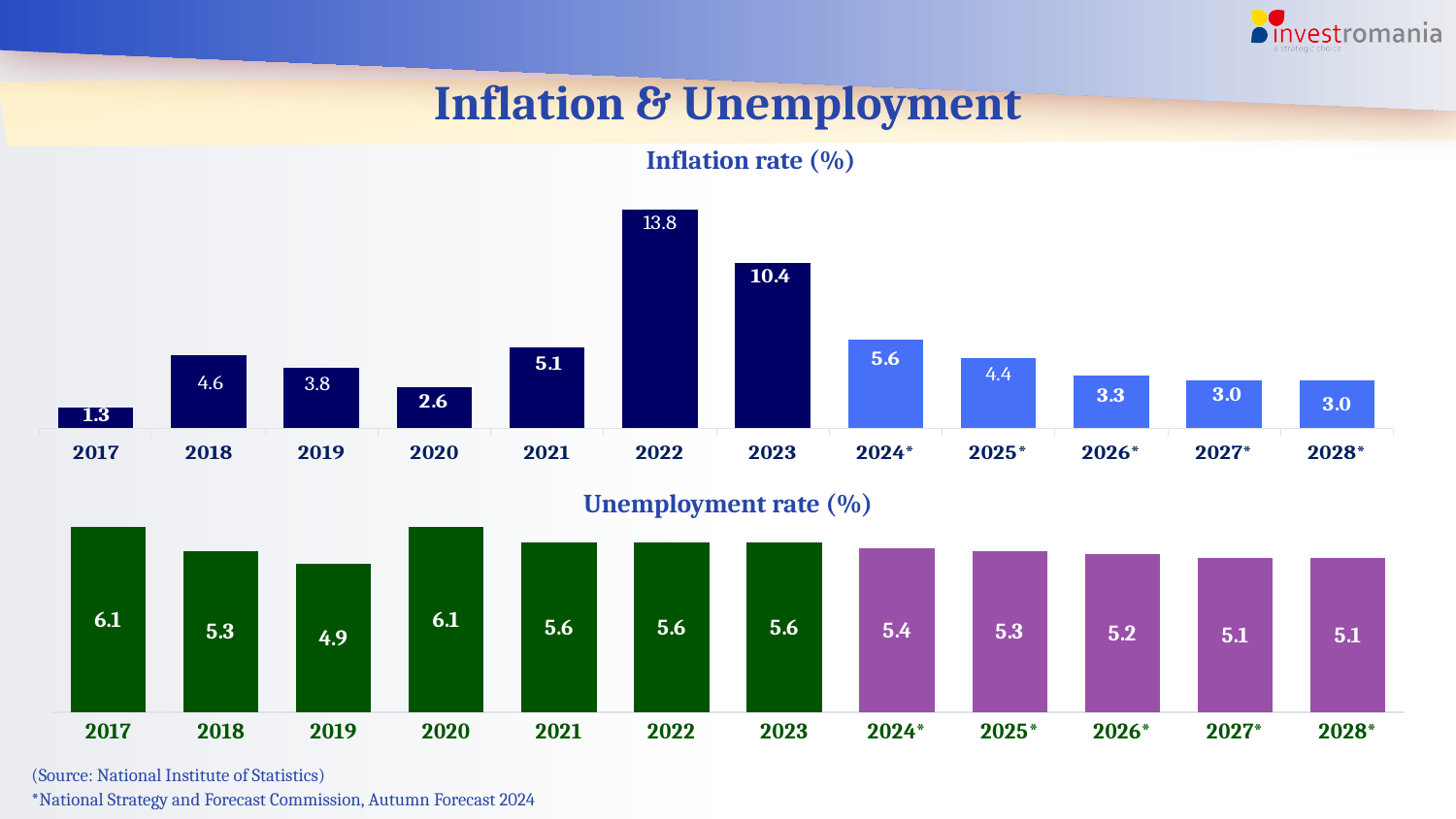
In the Inflation rate (%) chart, how many years are shown on the x axis? 12 In the Unemployment rate (%) chart, what is the value for 2019? 4.9 In the Inflation rate (%) chart, which year has the lowest inflation rate? 2017 In the Unemployment rate (%) chart, what colour are the bars for the forecast years 2024* to 2028*? purple In the Inflation rate (%) chart, which is larger, the value for 2018 or the value for 2019? 2018 In the Inflation rate (%) chart, what is the difference between the values for 2022 and 2023? 3.4 In the Inflation rate (%) chart, what is the value for 2022? 13.8 In the Unemployment rate (%) chart, which year has the lowest unemployment rate? 2019 In the Unemployment rate (%) chart, do the values rise or fall from 2024* to 2028*? fall What kind of chart is the Inflation rate (%) chart? bar chart In the Inflation rate (%) chart, what is the value for 2028*? 3.0 In the Unemployment rate (%) chart, what is the difference between the values for 2020 and 2024*? 0.7